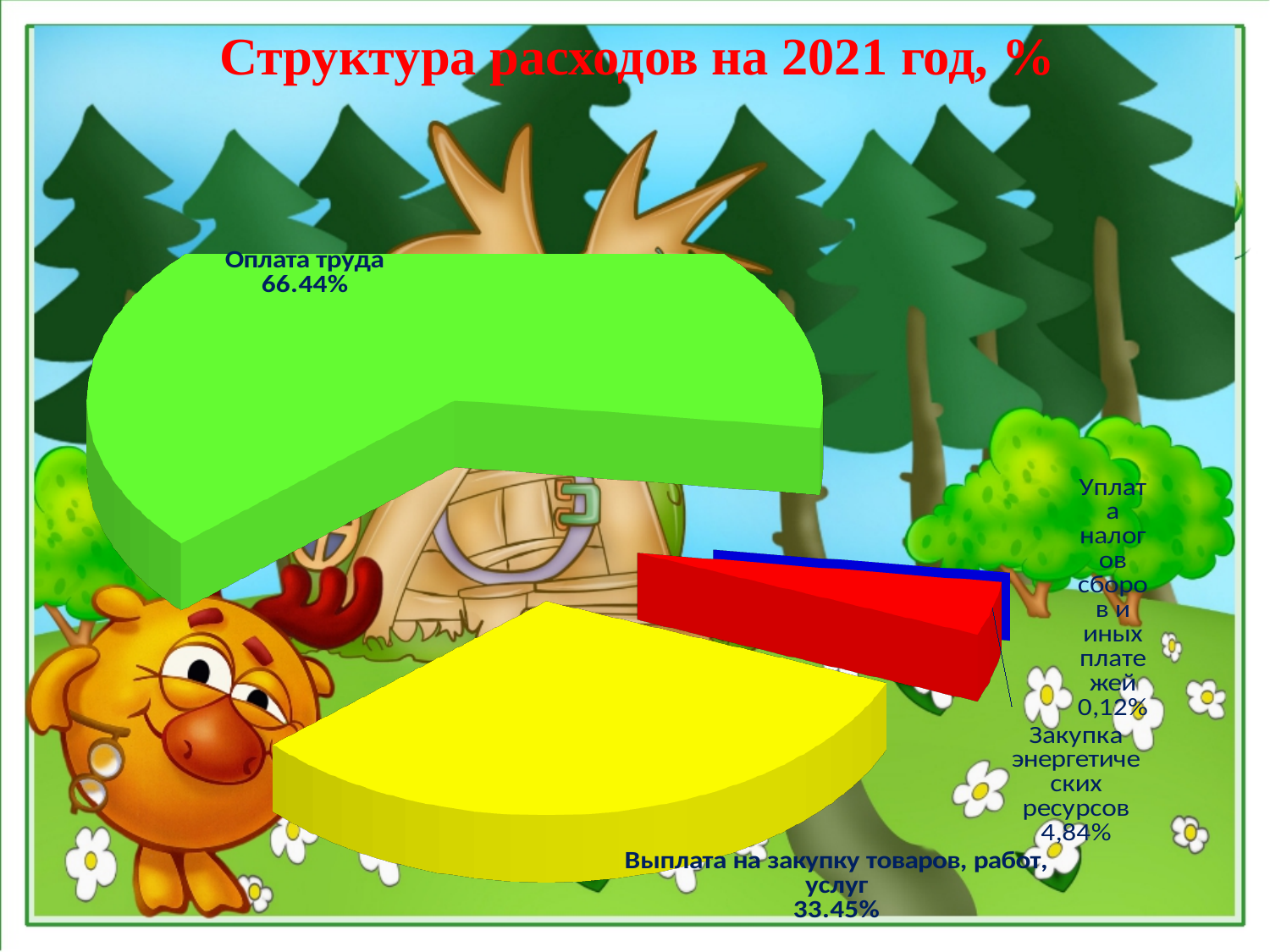
What colour is the slice for Оплата труда? green What type of chart is shown on the slide? pie chart What is the difference between Оплата труда and Выплата на закупку товаров, работ, услуг? 32.99% What is the value for Выплата на закупку товаров, работ, услуг? 33.45% What is the value for Уплата налогов сборов и иных платежей? 0,12% What is the value for Закупка энергетических ресурсов? 4,84% Which category has the largest share of the pie? Оплата труда How many slices does the pie chart have? 4 Which category has the smallest share of the pie? Уплата налогов сборов и иных платежей What is the title of the chart? Структура расходов на 2021 год, % What is the value for Оплата труда? 66.44% Which is larger: Оплата труда or Выплата на закупку товаров, работ, услуг? Оплата труда